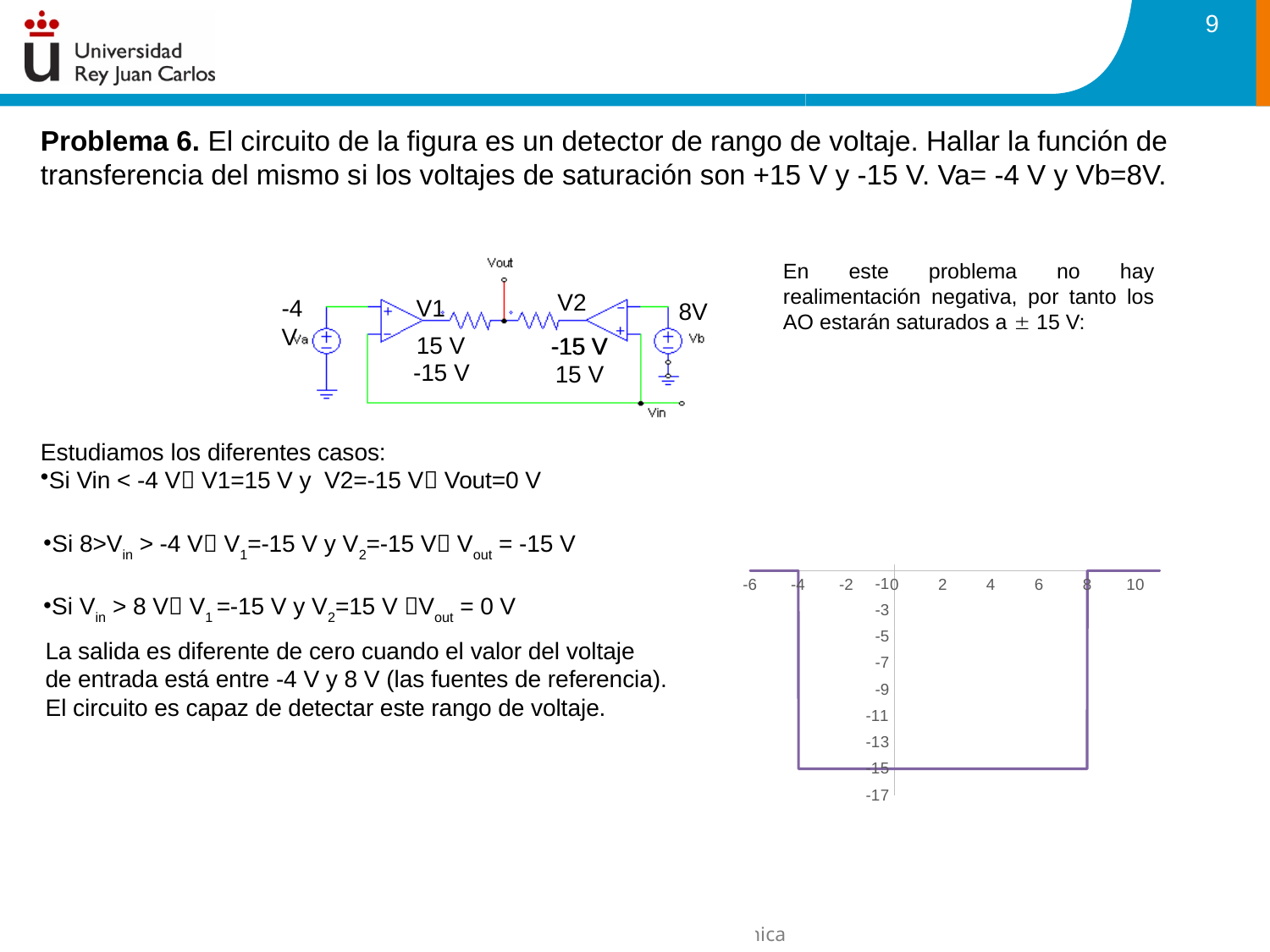
In the chart at the bottom right, what is the lowest value the line reaches? -15 What kind of chart is shown at the bottom right of the slide? line chart In the chart at the bottom right, which is larger: the value of the line at Vin = -6 or at Vin = 0? Vin = -6 In the chart at the bottom right, what is the value of the line at Vin = 4? -15 In the chart at the bottom right, at which x-axis value does the line rise back up from -15? 8 In the chart at the bottom right, is the value of the line at Vin = 6 greater or less than -5? less In the chart at the bottom right, does the line rise, fall or stay flat between Vin = -2 and Vin = 6? stays flat In the chart at the bottom right, is the value of the line at Vin = 10 greater or less than -5? greater In the chart at the bottom right, is the value of the line at Vin = 2 greater or less than -10? less In the chart at the bottom right, what is the lowest tick shown on the y axis? -17 In the chart at the bottom right, at which x-axis value does the line drop from the top level down to -15? -4 In the chart at the bottom right, what is the highest tick shown on the x axis? 10